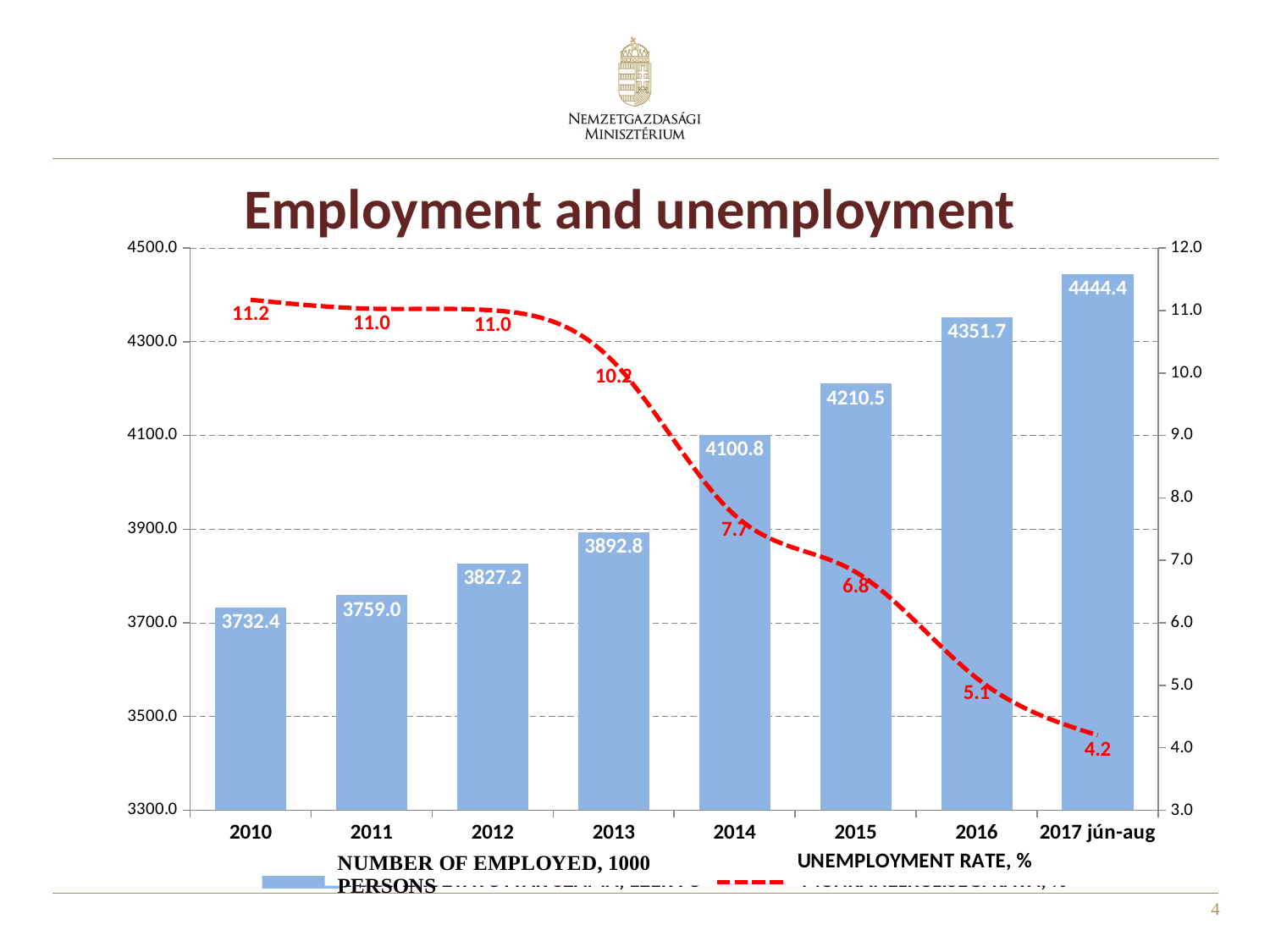
What is the unemployment rate in 2015? 6.8 How many series does the legend list? 2 Is the number of employed in 2012 greater or less than 3900.0? less What is the difference in the number of employed (1000 persons) between 2016 and 2015? 141.2 How many time periods are shown on the x axis? 8 How does the unemployment rate change from 2010 to 2017 jún-aug? It falls Which year has the highest unemployment rate? 2010 What is the number of employed (1000 persons) in 2014? 4100.8 What is the number of employed (1000 persons) for 2017 jún-aug? 4444.4 By how many percentage points did the unemployment rate fall from 2013 to 2014? 2.5 Which period has the lowest unemployment rate? 2017 jún-aug Which year has the lowest number of employed? 2010